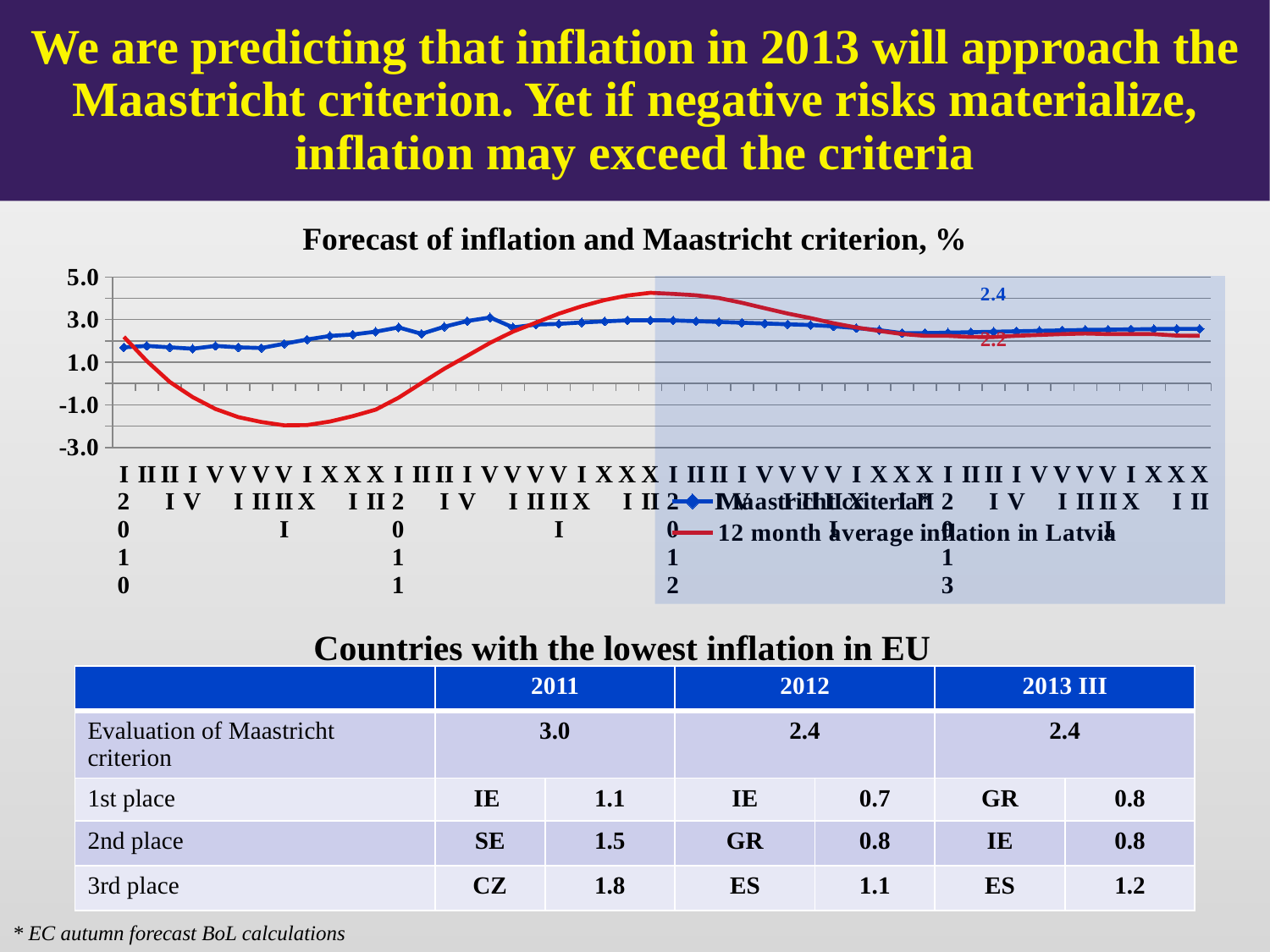
What value is labelled on the 'Maastricht criterion' line at the end of the forecast period? 2.4 What kind of chart is 'Forecast of inflation and Maastricht criterion, %'? line chart How many series does the legend of the inflation chart list? 2 What value is labelled on the '12 month average inflation in Latvia' line at the end of the forecast period? 2.2 Is the lowest point of the '12 month average inflation in Latvia' line greater or less than -1.0? less Which series reaches the lowest value anywhere on the chart? 12 month average inflation in Latvia What is the difference between the labelled end values of the Maastricht criterion (2.4) and the 12 month average inflation in Latvia (2.2)? 0.2 What colour is the 'Maastricht criterion' line in the chart? blue Is the peak of the '12 month average inflation in Latvia' line greater or less than 3.0? greater At the end of the forecast period, which is higher: the Maastricht criterion or the 12 month average inflation in Latvia? Maastricht criterion What are the two series named in the legend of the inflation chart? Maastricht criteria*; 12 month average inflation in Latvia Which series reaches the highest value anywhere on the chart? 12 month average inflation in Latvia